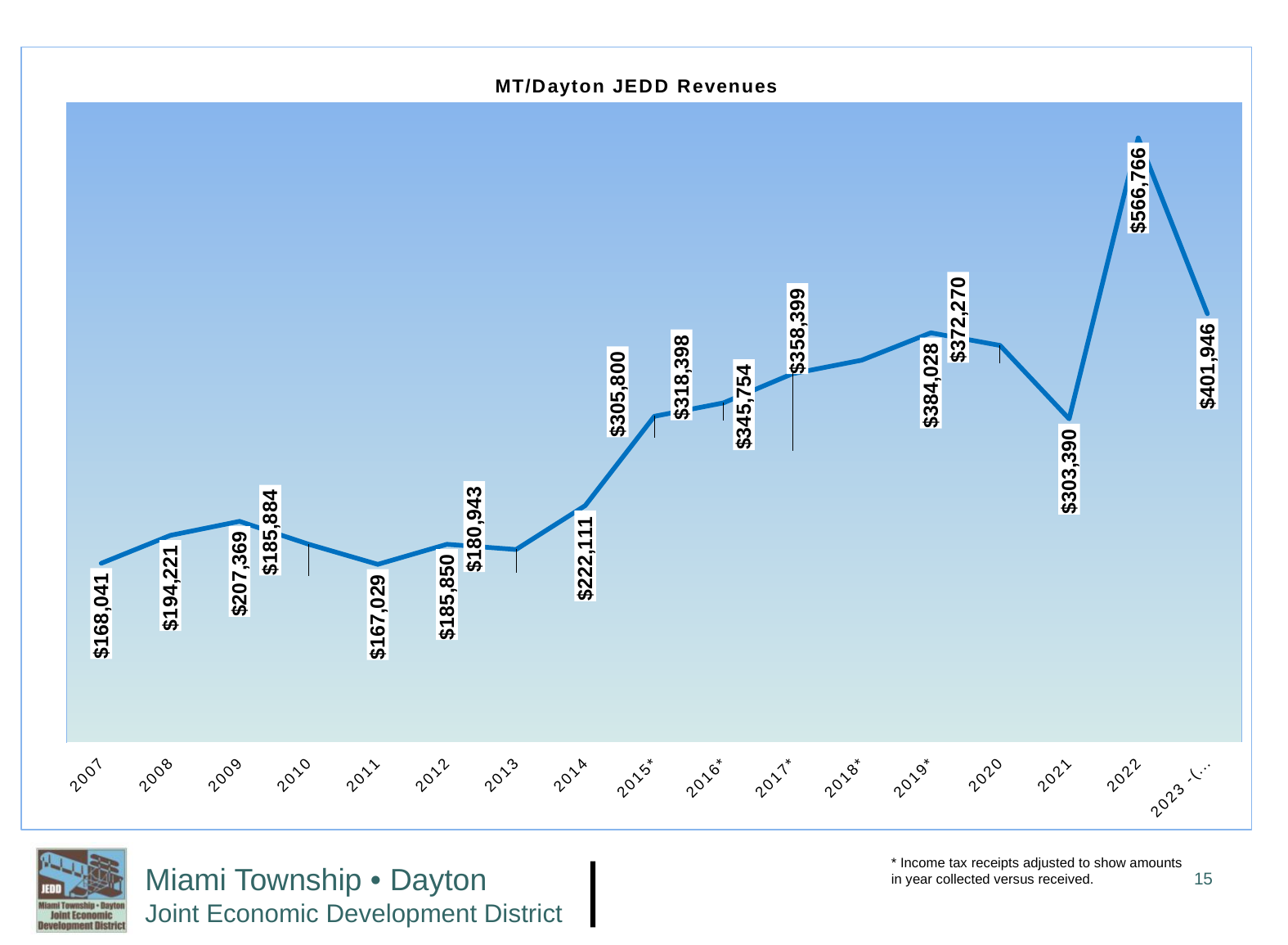
What was the MT/Dayton JEDD revenue in 2007? $168,041 Which year has the highest revenue on the chart? 2022 Which year has the lowest revenue on the chart? 2011 What was the MT/Dayton JEDD revenue in 2015*? $305,800 Do revenues rise or fall from 2019* to 2021? fall What is the title of the chart? MT/Dayton JEDD Revenues How many years (data points) are plotted on the chart? 17 What was the MT/Dayton JEDD revenue in 2021? $303,390 What is the difference between the 2022 revenue and the 2021 revenue? $263,376 What type of chart is shown on the slide? line chart Which year had higher revenue, 2019* or 2020? 2019* What was the MT/Dayton JEDD revenue in 2022? $566,766